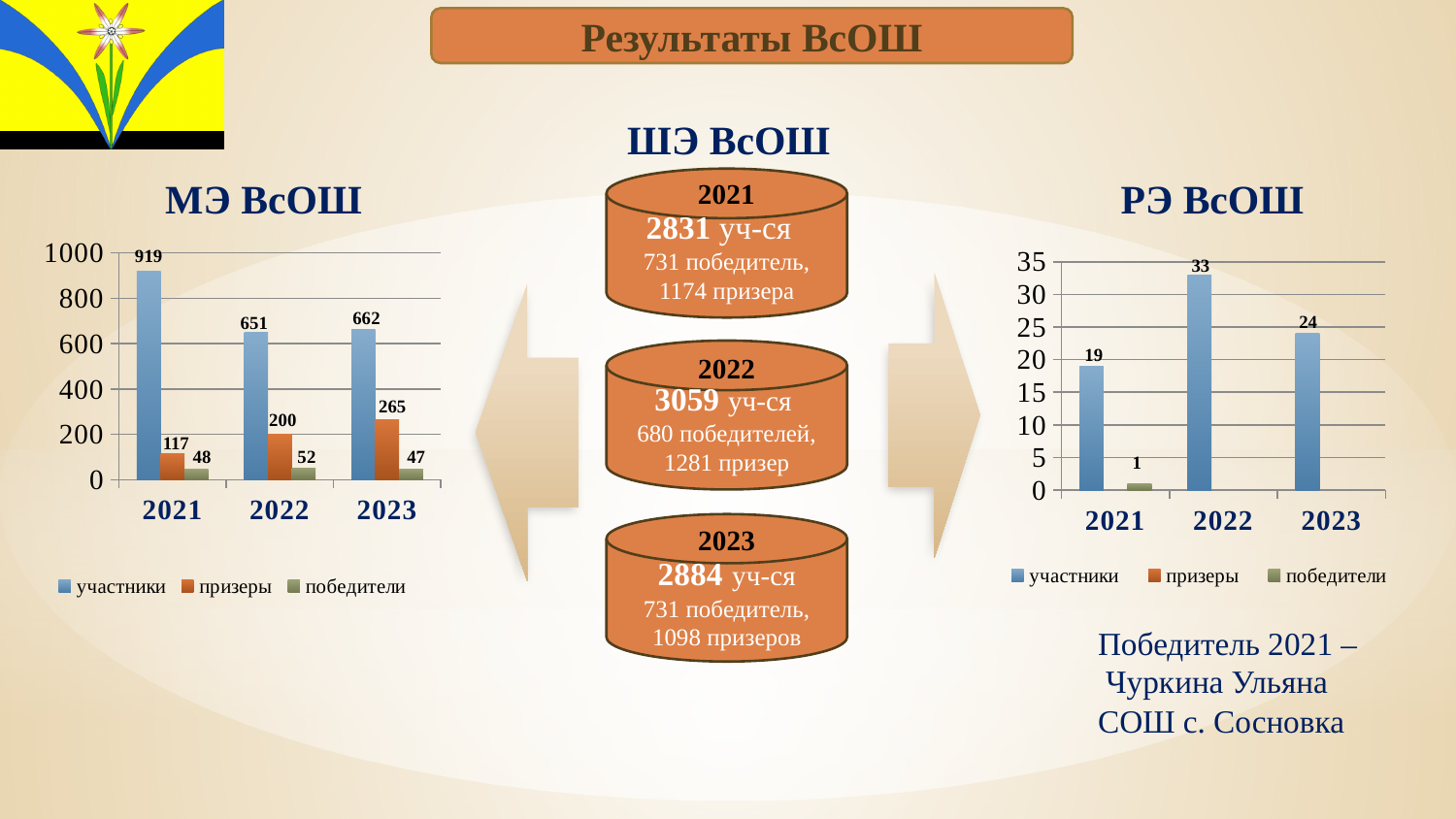
In the МЭ ВсОШ chart, do the values for призеры rise or fall from 2021 to 2023? rise In the РЭ ВсОШ chart, what is the difference between участники in 2022 and участники in 2023? 9 In the РЭ ВсОШ chart, what is the value for участники in 2022? 33 In the РЭ ВсОШ chart, which year has the highest value for участники? 2022 What type of chart is the РЭ ВсОШ chart? bar chart In the МЭ ВсОШ chart, what is the difference between участники in 2021 and участники in 2022? 268 In the МЭ ВсОШ chart, which year has the highest value for участники? 2021 In the МЭ ВсОШ chart, how many series does the legend list? 3 In the МЭ ВсОШ chart, which year has the lowest value for победители? 2023 In the МЭ ВсОШ chart, what is the value for участники in 2021? 919 In the МЭ ВсОШ chart, what is the value for призеры in 2023? 265